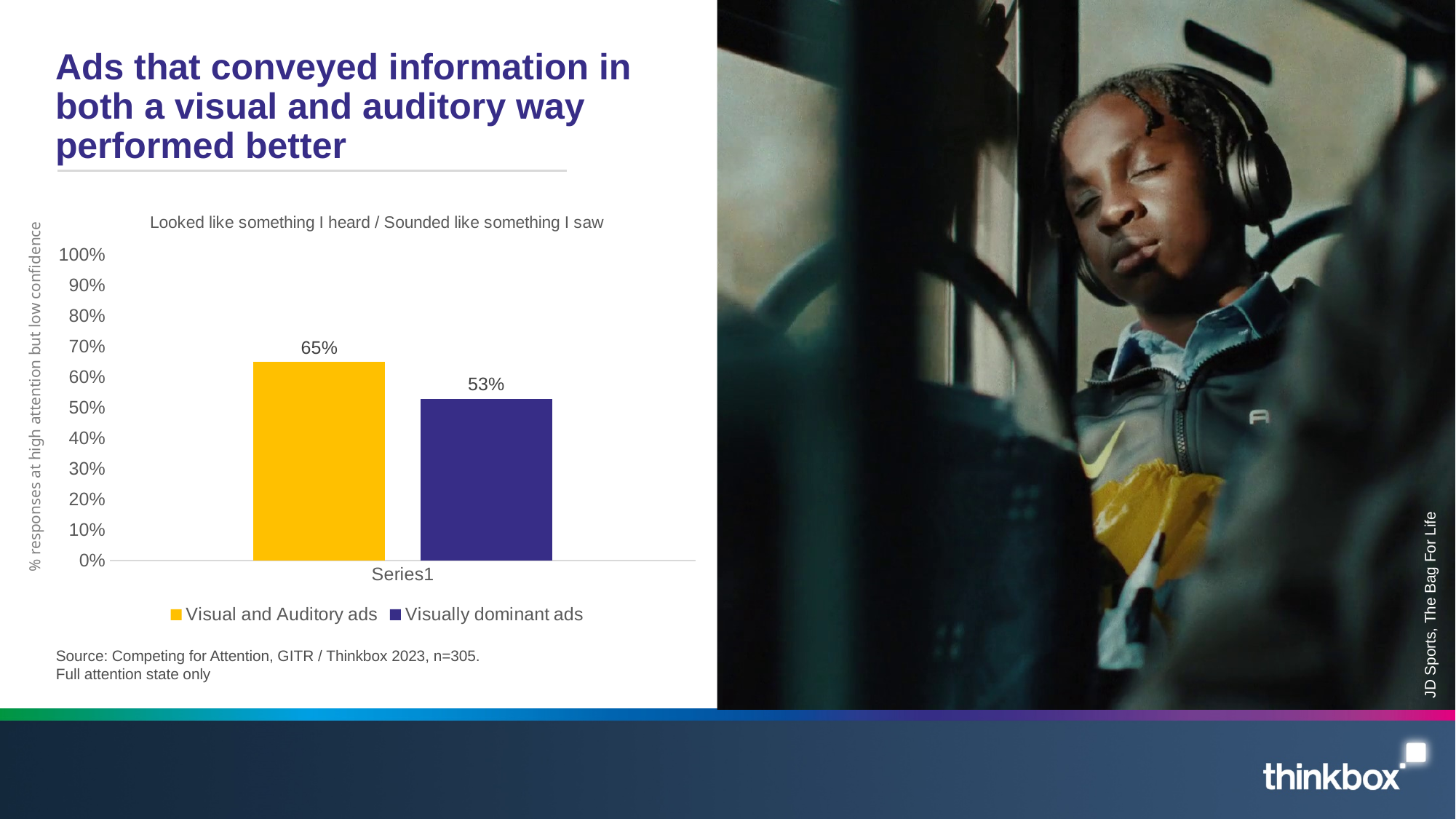
Which series has the highest value? Visual and Auditory ads Is the value for Visual and Auditory ads greater or less than 60%? greater Which series has the lowest value? Visually dominant ads What is the difference between the values for Visual and Auditory ads and Visually dominant ads? 12% What is the value for Visual and Auditory ads? 65% How many bars are plotted in the chart? 2 What is the value for Visually dominant ads? 53% How many series does the legend list? 2 What kind of chart is shown on the slide? Bar chart Which is larger, the value for Visual and Auditory ads or the value for Visually dominant ads? Visual and Auditory ads What is the title of the chart? Looked like something I heard / Sounded like something I saw Is the value for Visually dominant ads greater or less than 60%? less